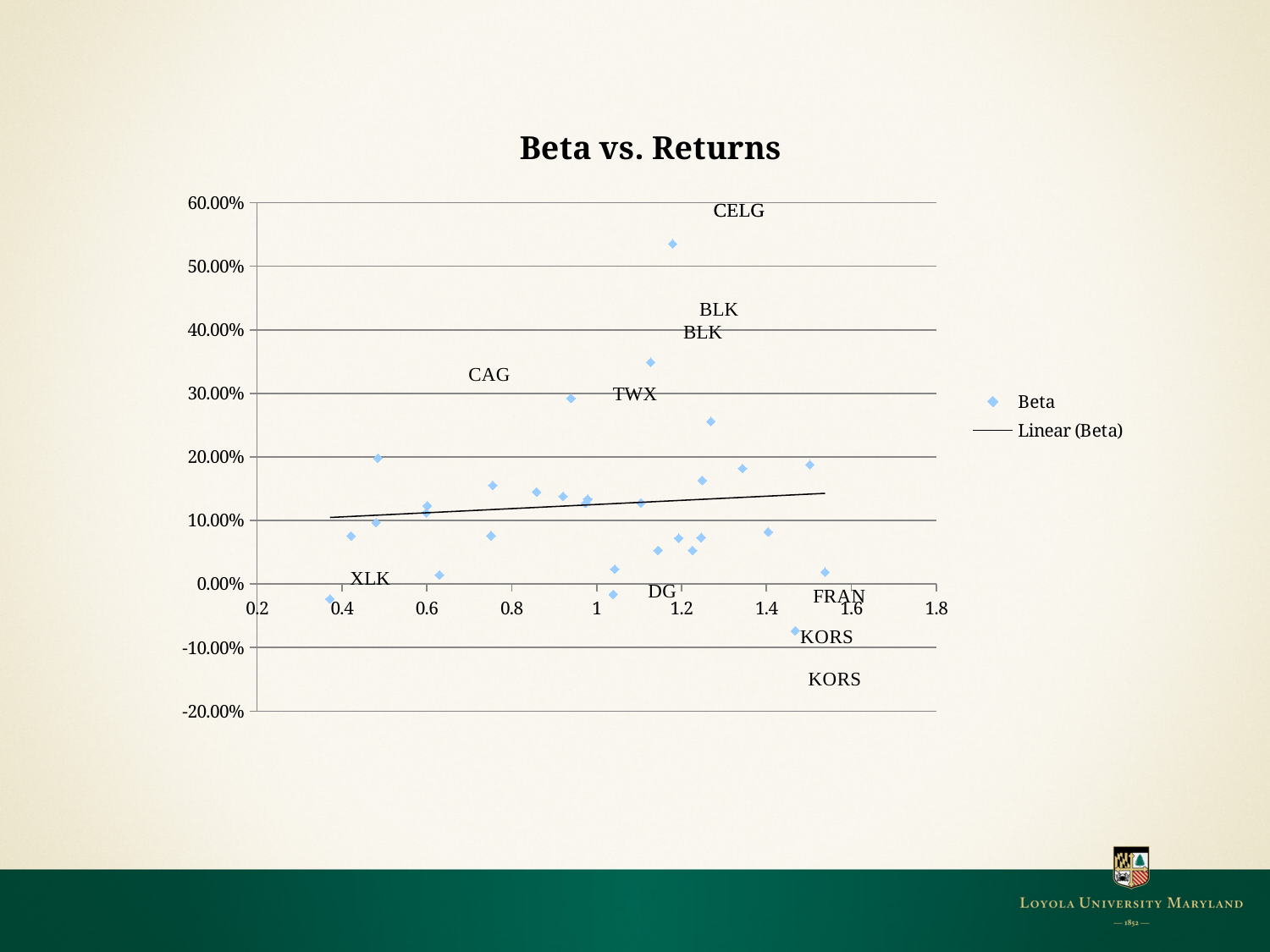
Which labeled stock has the highest return on the chart? CELG How many entries does the chart's legend list? 2 What kind of chart is shown on the slide? scatter chart Is the return for CELG greater or less than 50.00%? greater Does the linear trendline rise or fall as beta increases along the x axis? rise Is the return for CAG greater or less than 20.00%? greater Is the return for KORS greater or less than 0.00%? less What are the two entries in the chart's legend? Beta and Linear (Beta) What is the title of the chart? Beta vs. Returns Which labeled stock has the lowest return on the chart? KORS